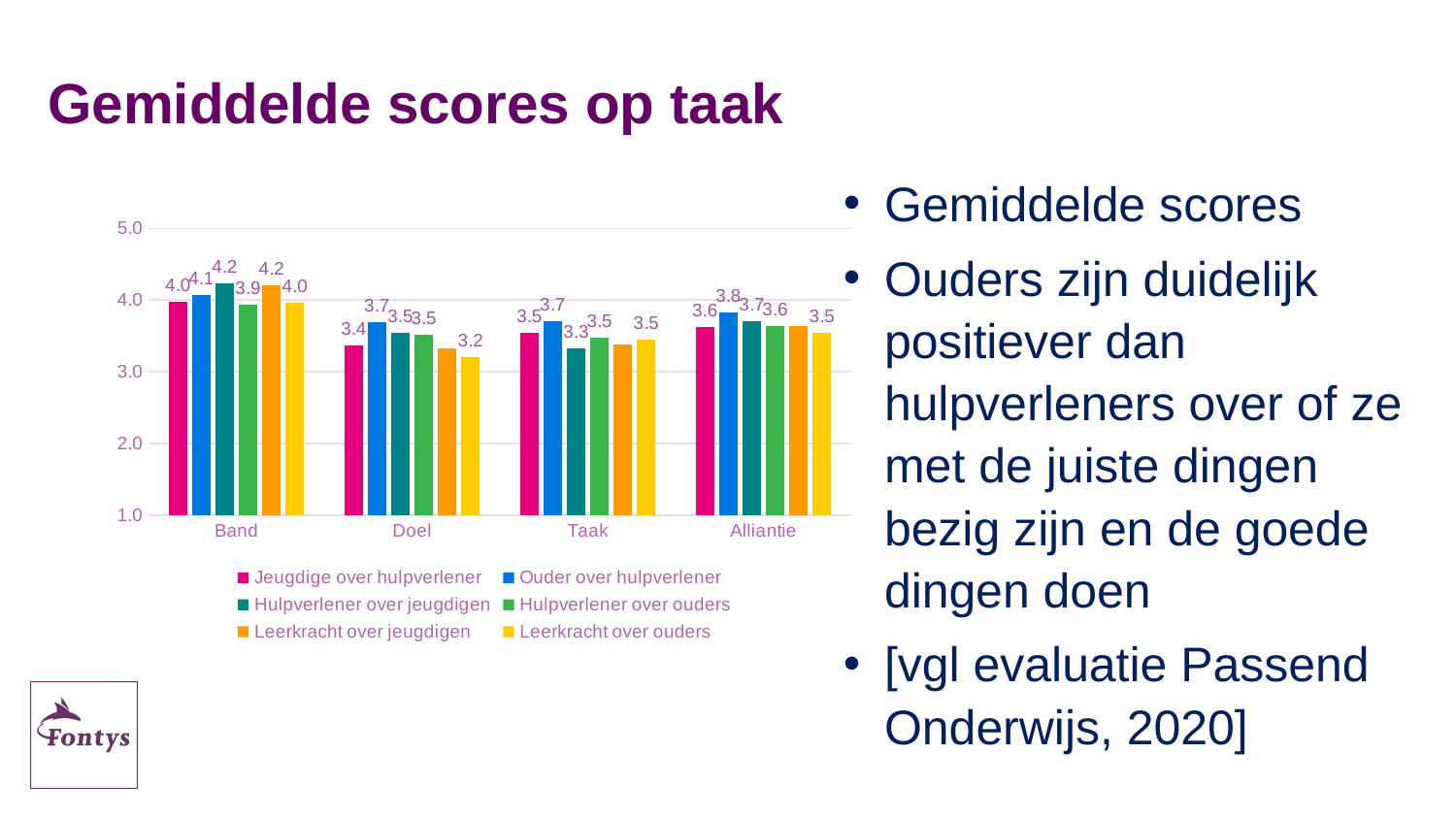
What is the difference between the Ouder over hulpverlener values for Band and Doel? 0.4 What is the value for Hulpverlener over jeugdigen in the Alliantie category? 3.7 Which series has the lowest value in the Doel category? Leerkracht over ouders What is the value for Ouder over hulpverlener in the Band category? 4.1 How many categories are shown on the x axis? 4 Is the value for Leerkracht over jeugdigen in the Band category greater or less than 4.0? greater What is the value for Jeugdige over hulpverlener in the Doel category? 3.4 Which series has the highest value in the Alliantie category? Ouder over hulpverlener In which category does Jeugdige over hulpverlener have its highest value? Band How many series does the legend list? 6 In the Taak category, which is larger: Hulpverlener over jeugdigen or Hulpverlener over ouders? Hulpverlener over ouders What kind of chart is shown on the slide? bar chart